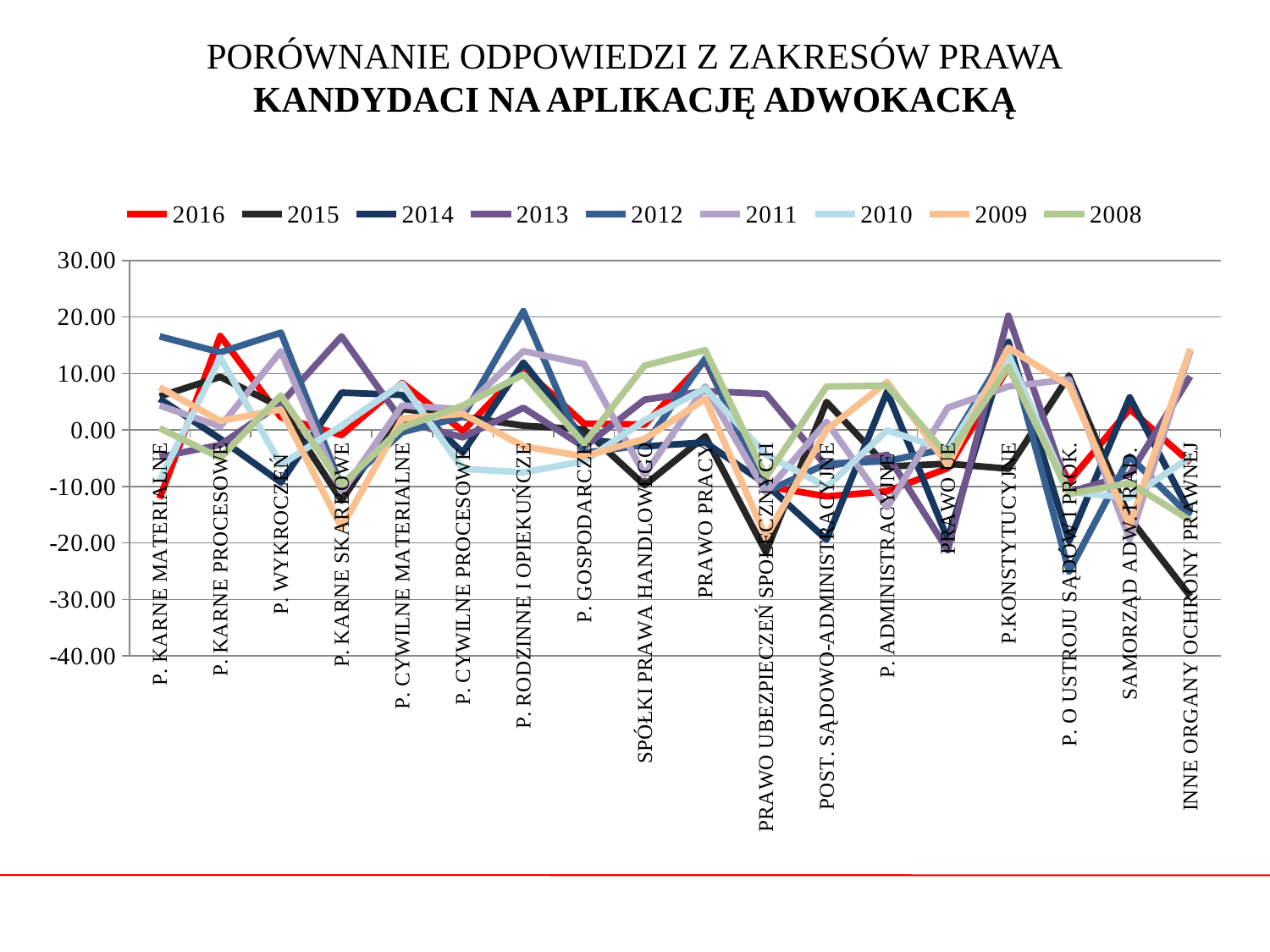
Is the 2009 value for P. KARNE SKARBOWE greater or less than -10.00? less How many series does the legend list? 9 At P. KARNE MATERIALNE, which is larger: the 2012 value or the 2016 value? 2012 How many categories are shown along the x axis? 18 Is the 2016 value for P. KARNE PROCESOWE greater or less than 10.00? greater Which series has the lowest value at INNE ORGANY OCHRONY PRAWNEJ? 2015 Is the 2012 value for P. RODZINNE I OPIEKUŃCZE greater or less than 20.00? greater Which years are listed in the legend? 2016, 2015, 2014, 2013, 2012, 2011, 2010, 2009, 2008 Which series has the highest value at P. RODZINNE I OPIEKUŃCZE? 2012 What kind of chart is shown on the slide? line chart What is the bold second line of the chart title? KANDYDACI NA APLIKACJĘ ADWOKACKĄ